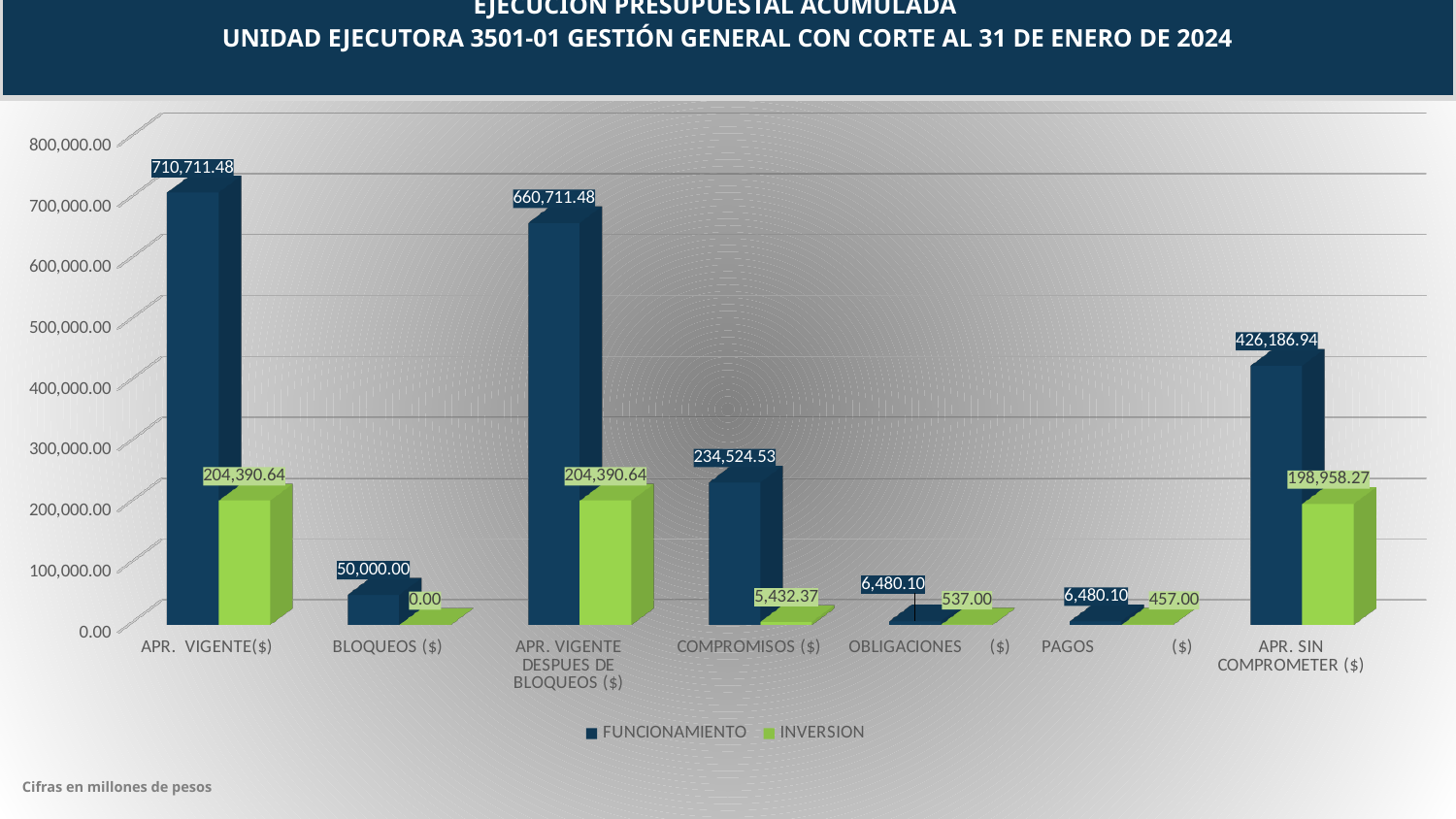
How many series does the legend list? 2 What is the FUNCIONAMIENTO value for APR. VIGENTE($)? 710,711.48 What is the INVERSION value for BLOQUEOS ($)? 0.00 Which category has the highest FUNCIONAMIENTO value? APR. VIGENTE($) What kind of chart is shown on the slide? bar chart Which is larger: the INVERSION value for OBLIGACIONES ($) or for PAGOS ($)? OBLIGACIONES ($) What is the INVERSION value for APR. SIN COMPROMETER ($)? 198,958.27 How many categories are shown on the x axis? 7 What is the FUNCIONAMIENTO value for COMPROMISOS ($)? 234,524.53 Is the FUNCIONAMIENTO value for APR. SIN COMPROMETER ($) greater or less than 400,000.00? greater What is the difference between the FUNCIONAMIENTO values for APR. VIGENTE($) and APR. VIGENTE DESPUES DE BLOQUEOS ($)? 50,000.00 Which category has the lowest INVERSION value? BLOQUEOS ($)